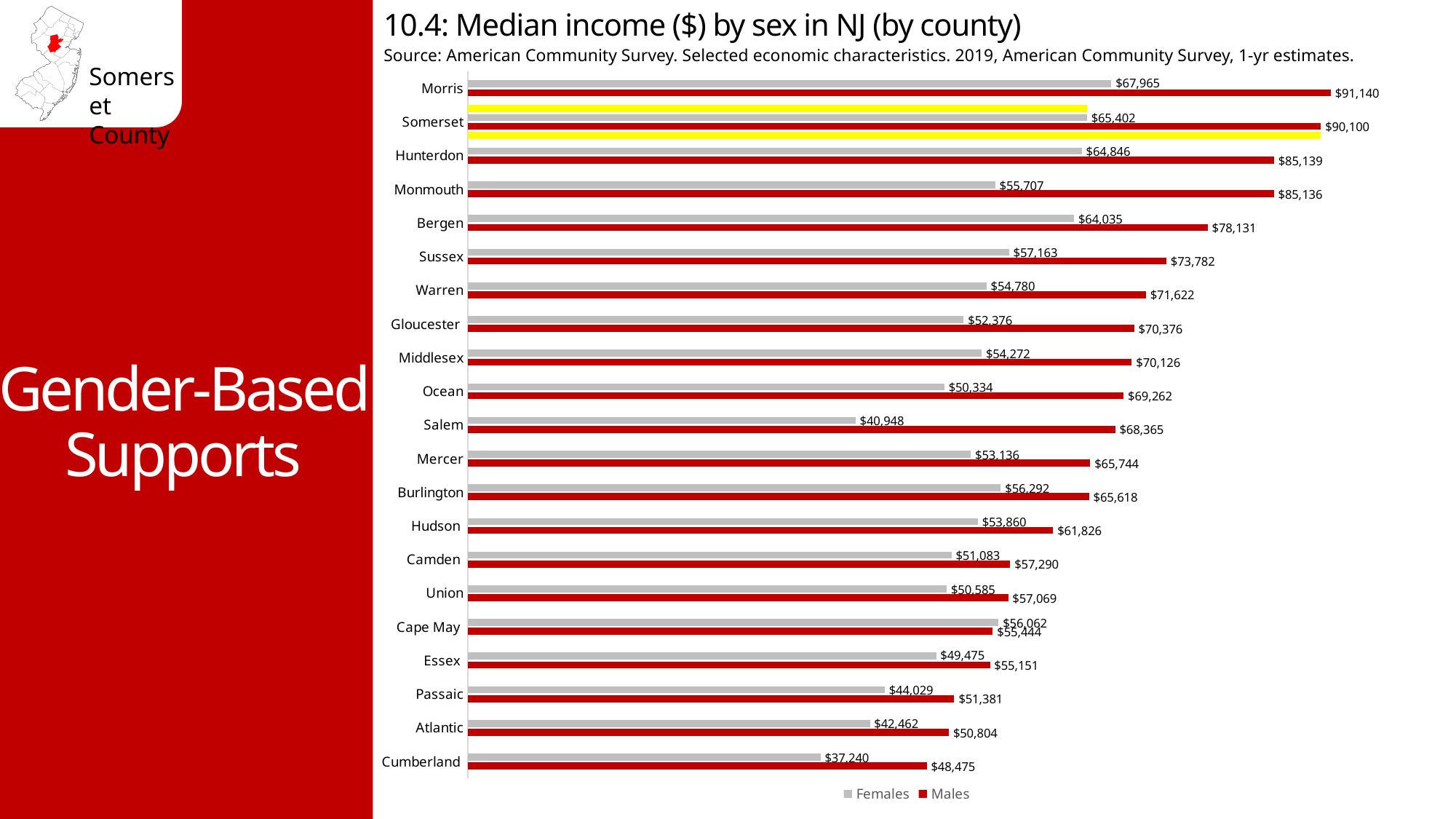
Which county has a higher median income for males, Bergen or Sussex? Bergen Which county has the lowest median income for females? Cumberland Which is larger in Cape May County, the median income for females or for males? Females What is the median income for males in Morris County? $91,140 What is the median income for males in Cumberland County? $48,475 What is the difference between the male and female median income in Morris County? $23,175 What is the difference between the male and female median income in Somerset County? $24,698 How many series does the legend list? 2 What is the median income for females in Somerset County? $65,402 What type of chart is shown on the slide? Bar chart Which county has the highest median income for males? Morris How many counties are shown in the chart? 21